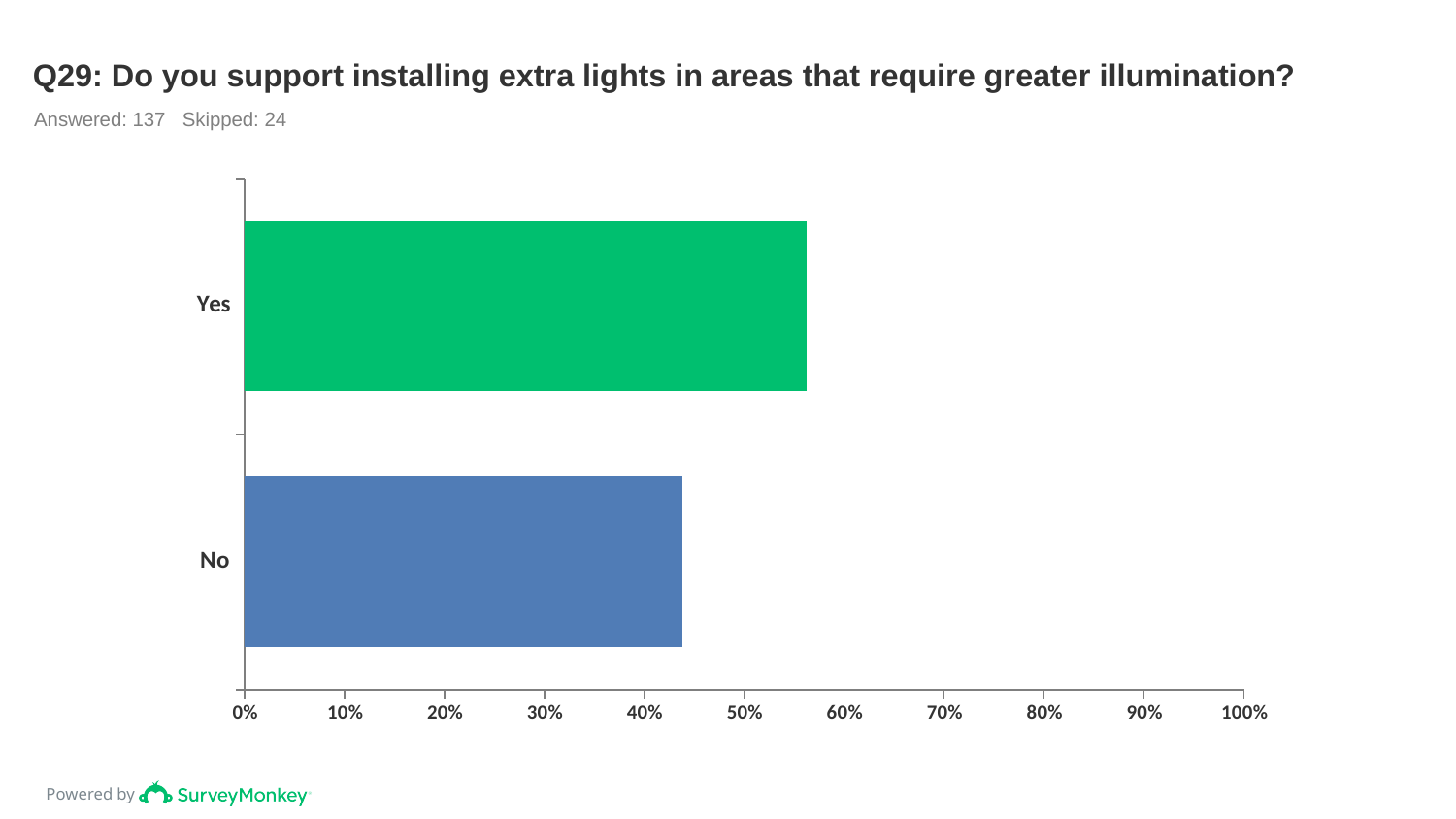
Is the value for No greater or less than 40%? greater How many respondents answered this question according to the slide? 137 Which category has the highest value? Yes Is the value for No greater or less than 50%? less Which is larger, the value for Yes or the value for No? Yes Which category has the lowest value? No Is the value for Yes greater or less than 50%? greater What is the title of the chart? Q29: Do you support installing extra lights in areas that require greater illumination? What kind of chart is shown on the slide? bar chart How many categories does the chart show? 2